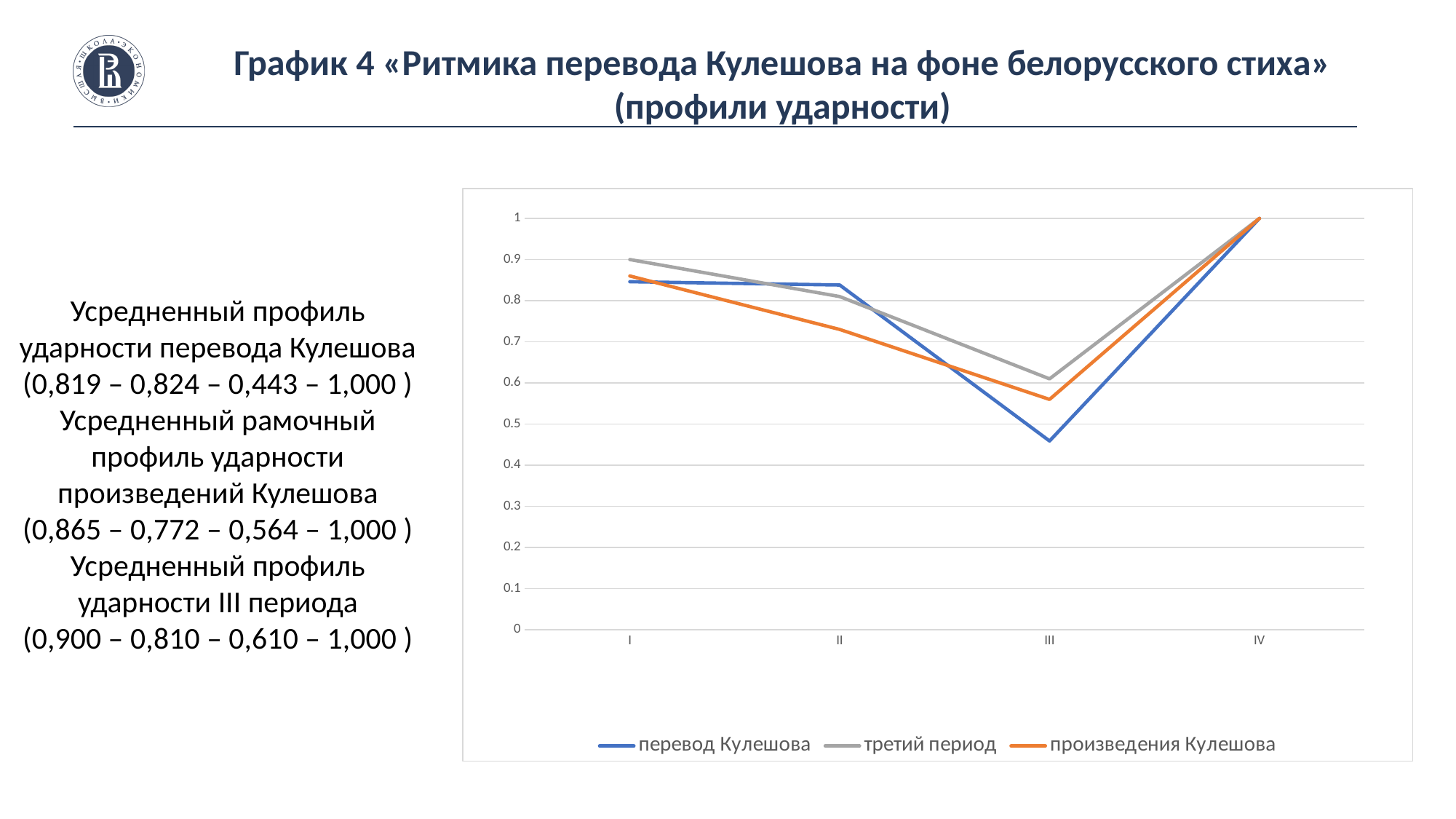
What is the value for перевод Кулешова at IV? 1 Is the value for третий период at I greater or less than 0.8? greater At II, which is larger: перевод Кулешова or произведения Кулешова? перевод Кулешова Which series has the highest value at III? третий период Which series has the lowest value at III? перевод Кулешова Is the value for произведения Кулешова at III greater or less than 0.5? greater What kind of chart is shown on the slide? line chart How many categories are on the x axis? 4 Is the value for произведения Кулешова at II greater or less than 0.8? less Does the line for третий период rise or fall from I to III? fall How many series does the legend list? 3